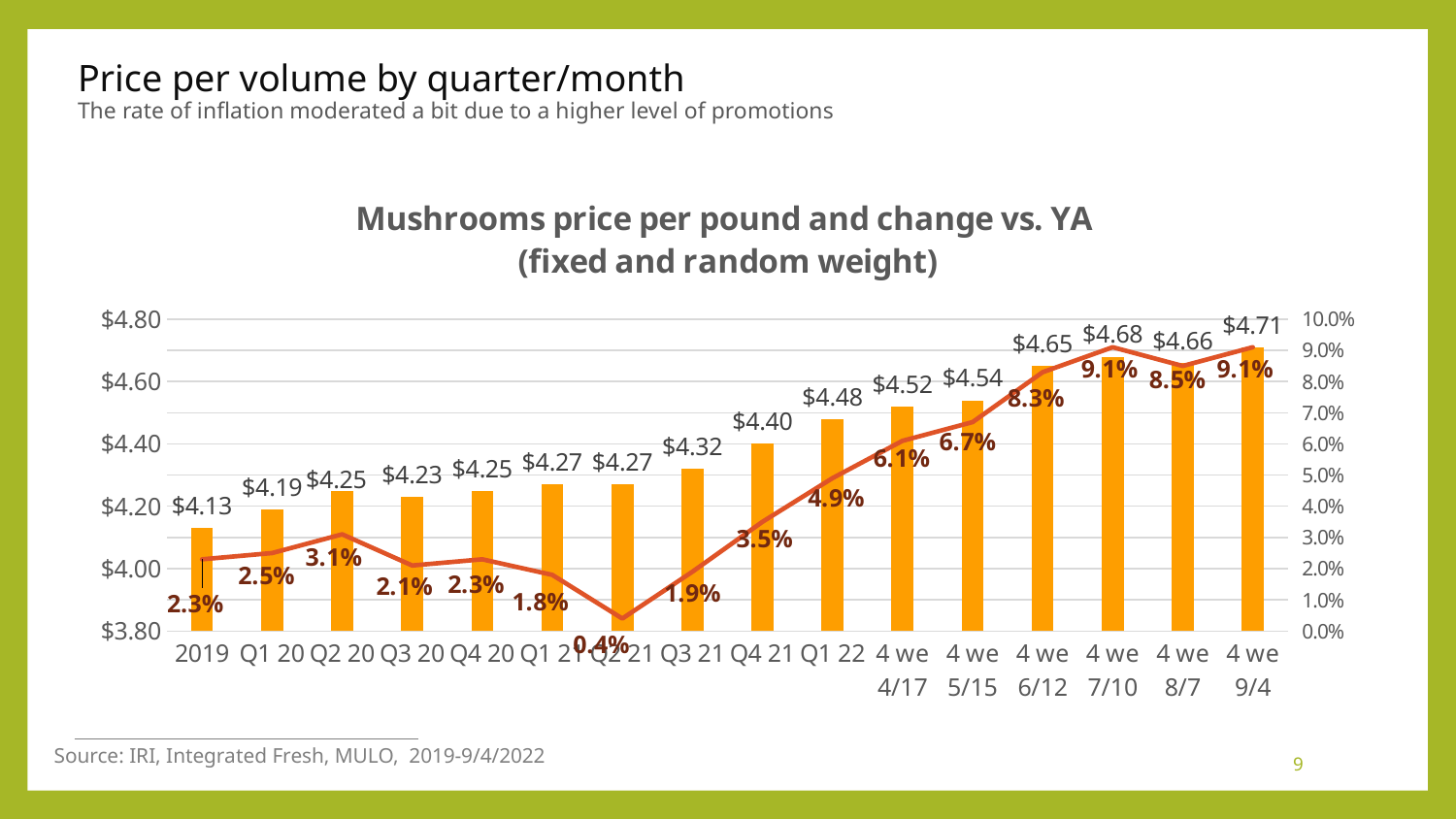
Which period has the lowest price per pound? 2019 Do the price per pound bars generally rise or fall from 2019 to 4 we 9/4? Rise What kind of chart is this? Combination bar and line chart What is the change vs. YA shown for the 4 weeks ending 6/12? 8.3% Which period has the highest price per pound? 4 we 9/4 What is the title of the chart? Mushrooms price per pound and change vs. YA (fixed and random weight) Which period has the lowest change vs. YA? Q2 21 What is the mushroom price per pound shown for Q4 21? $4.40 What is the change vs. YA shown for Q1 22? 4.9% How many periods are shown on the x axis? 16 What is the difference between the price per pound for 4 we 9/4 and for 2019? $0.58 Which has the higher price per pound, Q3 20 or Q4 20? Q4 20